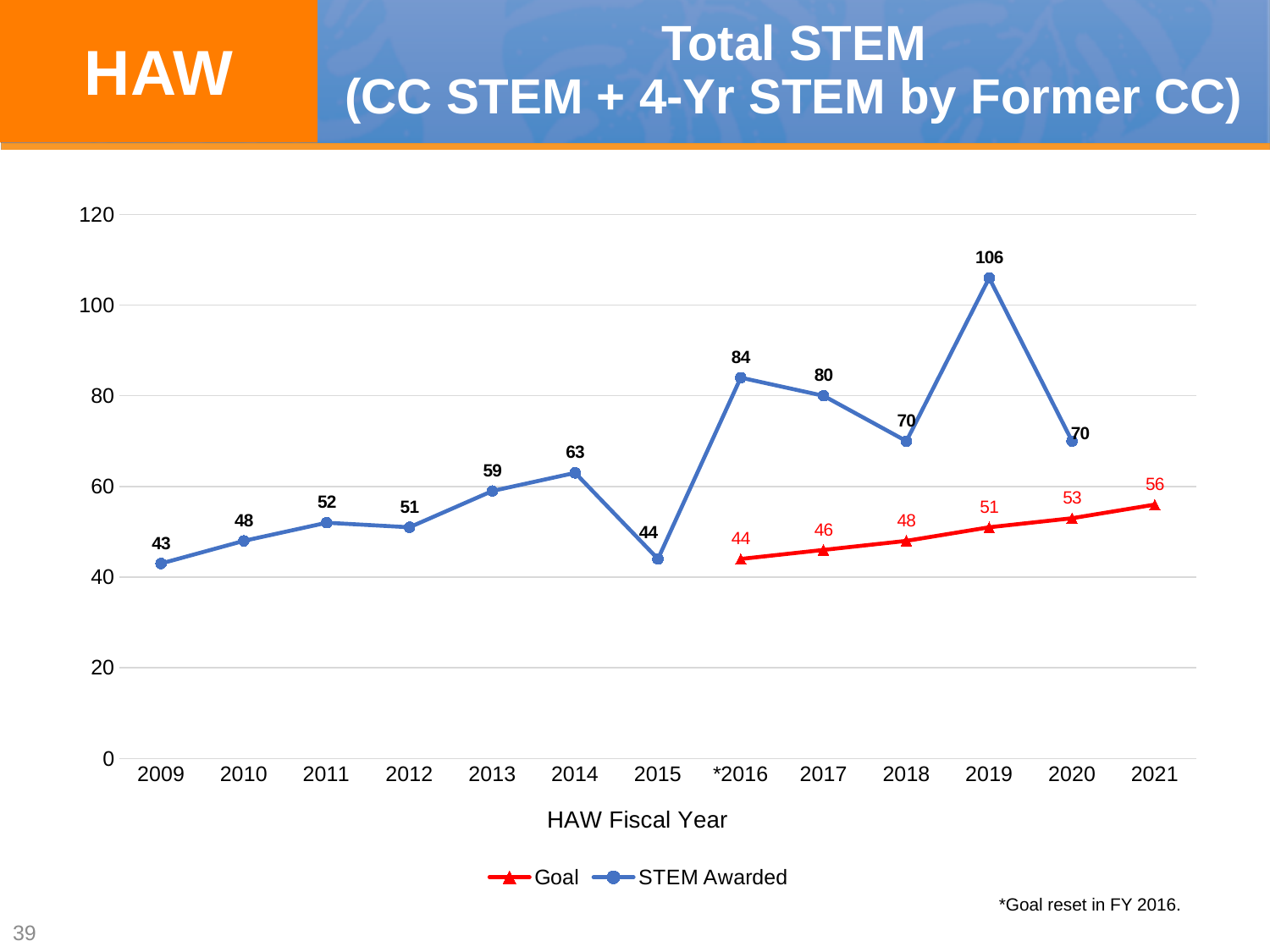
What is the Goal value for 2021? 56 Is the STEM Awarded value for 2016 greater or less than 80? greater In which year is the STEM Awarded value highest? 2019 How many years are shown on the x axis? 13 Does the Goal series rise or fall from 2016 to 2021? rise How many series does the legend list? 2 What is the STEM Awarded value for 2019? 106 What is the STEM Awarded value for 2009? 43 What is the difference between the STEM Awarded value in 2019 and in 2020? 36 What kind of chart is shown on the slide? line chart In 2018, which is larger: the Goal value or the STEM Awarded value? STEM Awarded In which year is the STEM Awarded value lowest? 2009